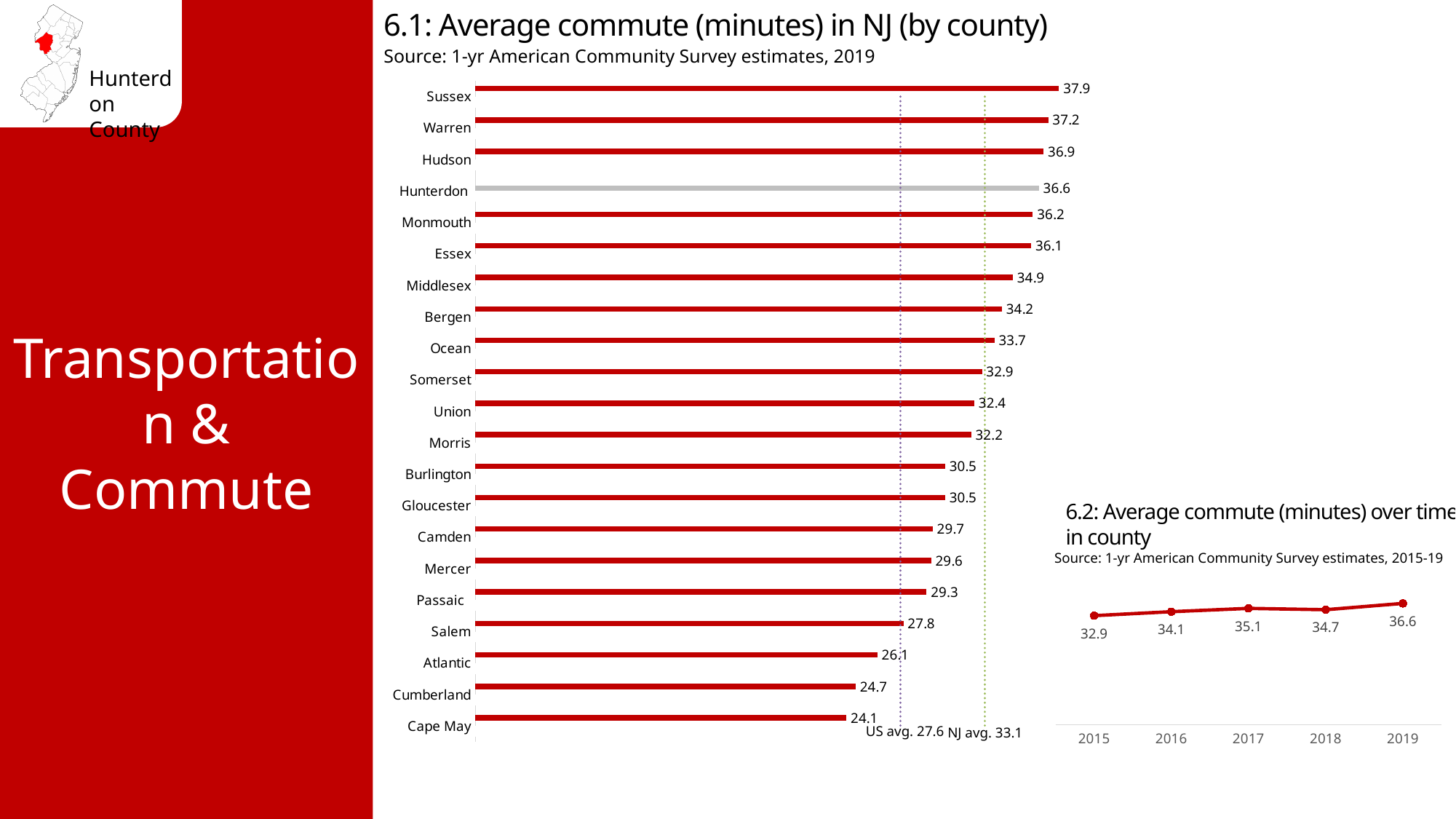
In chart 6.2 (Average commute over time in county), does the average commute generally rise or fall from 2015 to 2019? Rise In chart 6.1 (Average commute in NJ by county), which county has a longer average commute, Bergen or Ocean? Bergen In chart 6.1 (Average commute in NJ by county), what is the average commute for Hunterdon? 36.6 In chart 6.1 (Average commute in NJ by county), how many counties are shown? 21 In chart 6.1 (Average commute in NJ by county), what is the difference between the average commute for Sussex and Cape May? 13.8 In chart 6.1 (Average commute in NJ by county), what NJ average value is marked by the dotted reference line? 33.1 In chart 6.1 (Average commute in NJ by county), what is the average commute for Atlantic? 26.1 In chart 6.2 (Average commute over time in county), what is the difference between the 2019 and 2015 values? 3.7 What kind of chart is chart 6.1 (Average commute in NJ by county)? Bar chart In chart 6.1 (Average commute in NJ by county), which county has the lowest average commute? Cape May In chart 6.2 (Average commute over time in county), what was the average commute in 2017? 35.1 In chart 6.1 (Average commute in NJ by county), which county has the highest average commute? Sussex